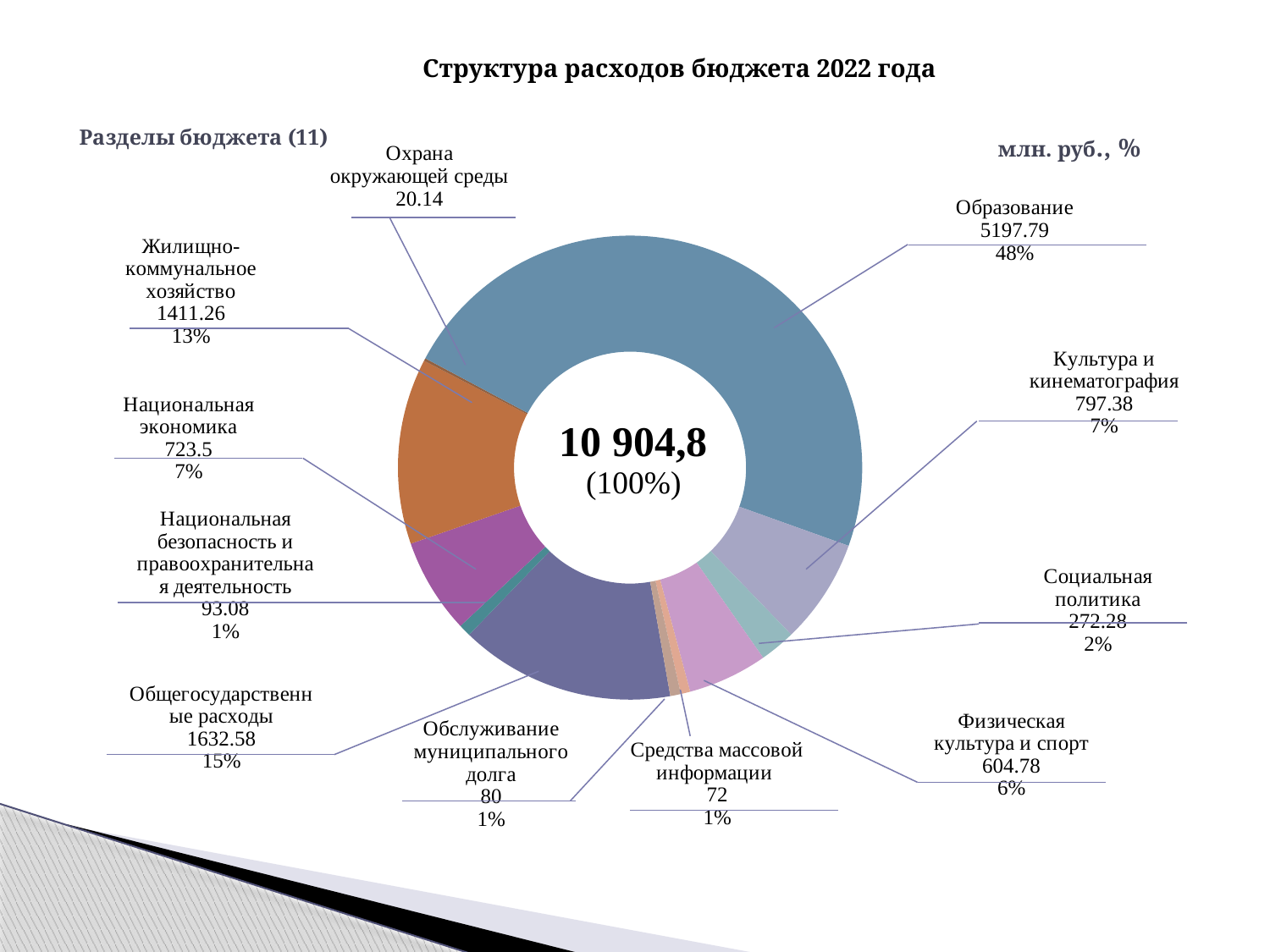
Which budget section has the largest share? Образование What total value is shown in the centre of the chart? 10 904,8 What share of the budget does Социальная политика account for? 2% What is the difference between Общегосударственные расходы and Жилищно-коммунальное хозяйство in млн. руб.? 221.32 How many budget sections (categories) does the chart show? 11 What is the title of the chart? Разделы бюджета (11) What is the value for Образование in млн. руб.? 5197.79 What share of the budget does Образование account for? 48% What kind of chart is shown on the slide? Pie chart (doughnut) What is the value for Жилищно-коммунальное хозяйство? 1411.26 Which is larger: Национальная экономика or Физическая культура и спорт? Национальная экономика Which budget section has the smallest value? Охрана окружающей среды